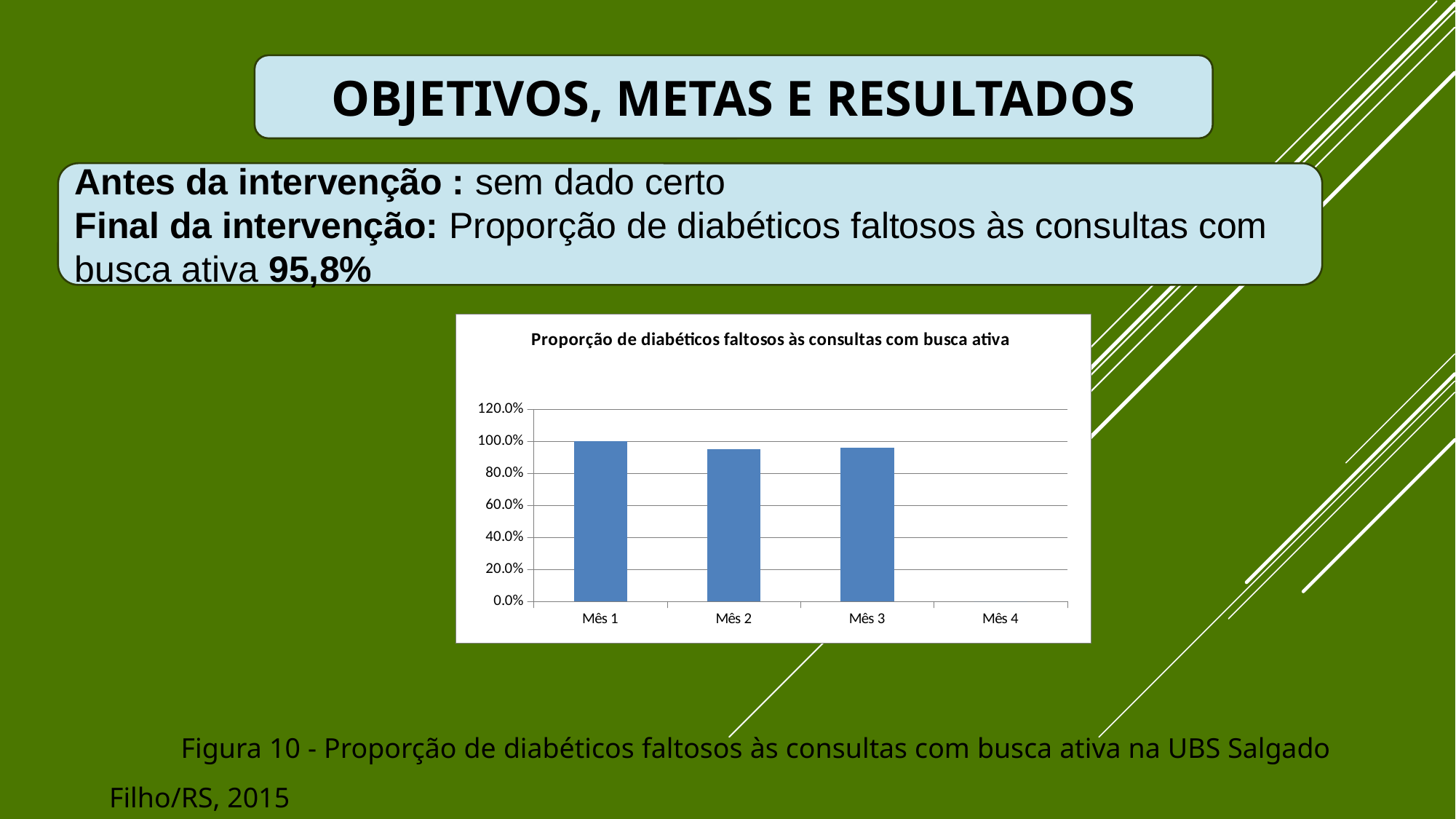
Which category on the x axis has no bar plotted? Mês 4 What is the highest value shown on the y axis of the chart? 120.0% Is the value for Mês 3 greater or less than 100.0%? less What is the title of the chart? Proporção de diabéticos faltosos às consultas com busca ativa Does the value rise or fall from Mês 1 to Mês 2? fall Is the value for Mês 2 greater or less than 100.0%? less How many categories are shown on the x axis of the chart? 4 Is the value for Mês 2 greater or less than 80.0%? greater Which is larger, the value for Mês 1 or the value for Mês 3? Mês 1 What is the value for Mês 1? 100.0% What kind of chart is shown on the slide? bar chart Which category has the highest bar? Mês 1